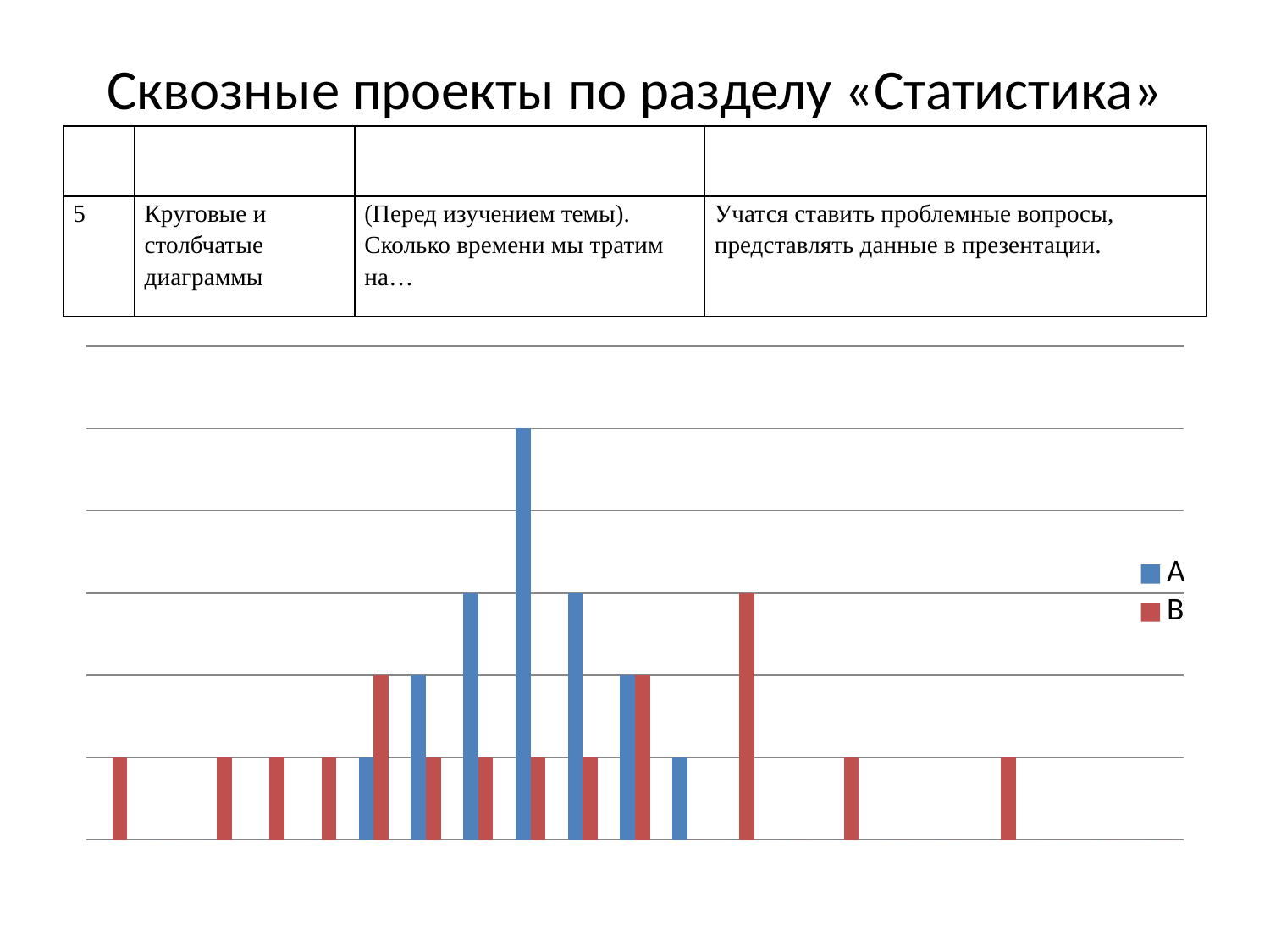
What kind of chart is shown on the slide? bar chart How many bars belong to series A in the chart? 7 Which series contains the tallest bar in the chart? A What are the series names listed in the chart legend? A and B How many series does the chart legend list? 2 Which colour represents series B in the chart? red